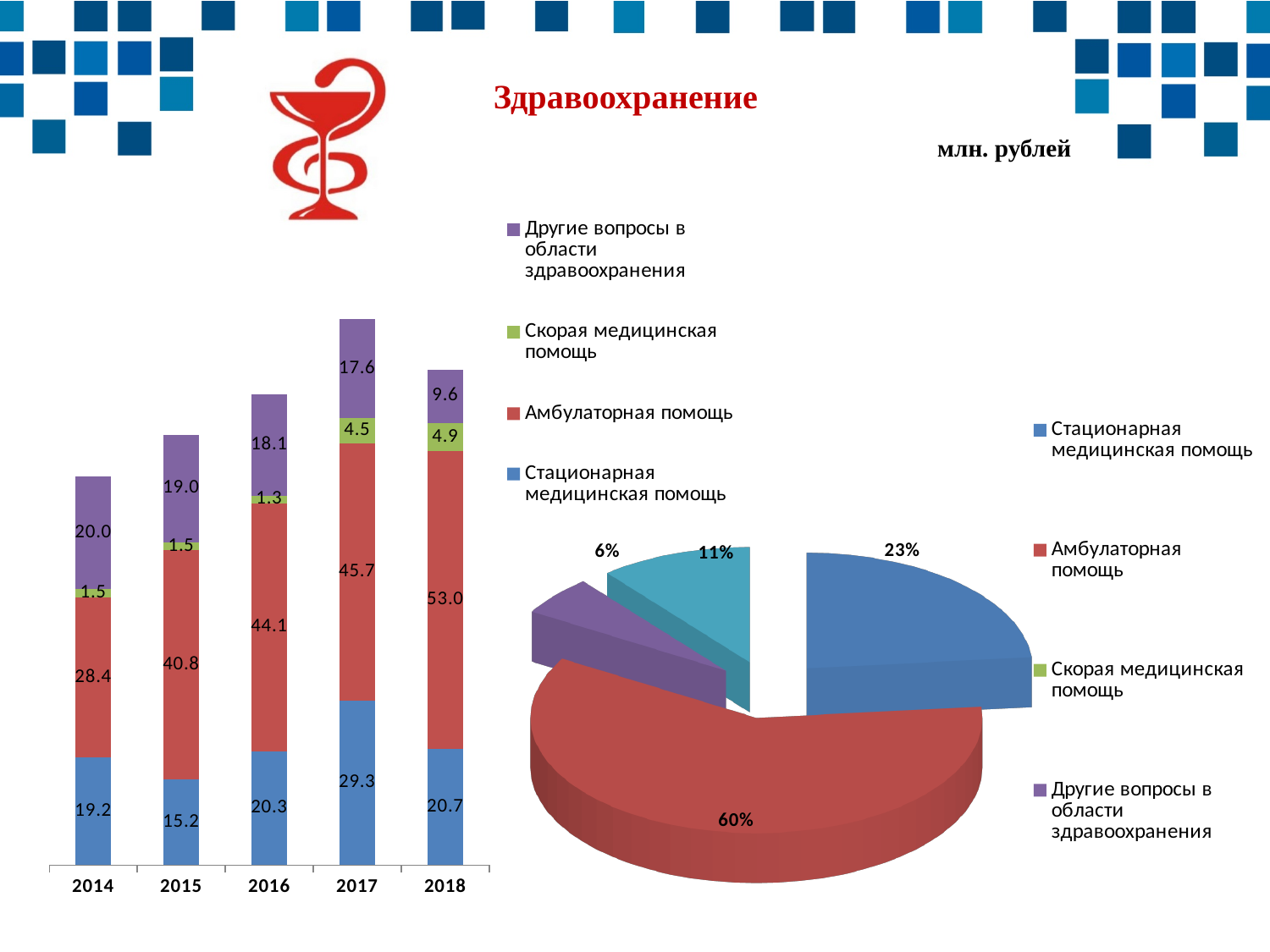
In the stacked bar chart on the left, what is the difference between the Амбулаторная помощь values for 2018 and 2017? 7.3 In the stacked bar chart on the left, how many series does the legend list? 4 In the stacked bar chart on the left, what is the value for Другие вопросы в области здравоохранения in 2014? 20.0 In the stacked bar chart on the left, what is the value for Скорая медицинская помощь in 2016? 1.3 In the stacked bar chart on the left, what is the total of the 2018 bar? 88.2 In the stacked bar chart on the left, which year has the lowest value for Стационарная медицинская помощь? 2015 In the stacked bar chart on the left, which year has the highest value for Амбулаторная помощь? 2018 In the pie chart on the right, what share does Амбулаторная помощь have? 60% In the stacked bar chart on the left, how many years are shown on the x axis? 5 In the pie chart on the right, what share does Стационарная медицинская помощь have? 23% In the stacked bar chart on the left, what is the value for Стационарная медицинская помощь in 2017? 29.3 In the stacked bar chart on the left, what is the value for Амбулаторная помощь in 2018? 53.0